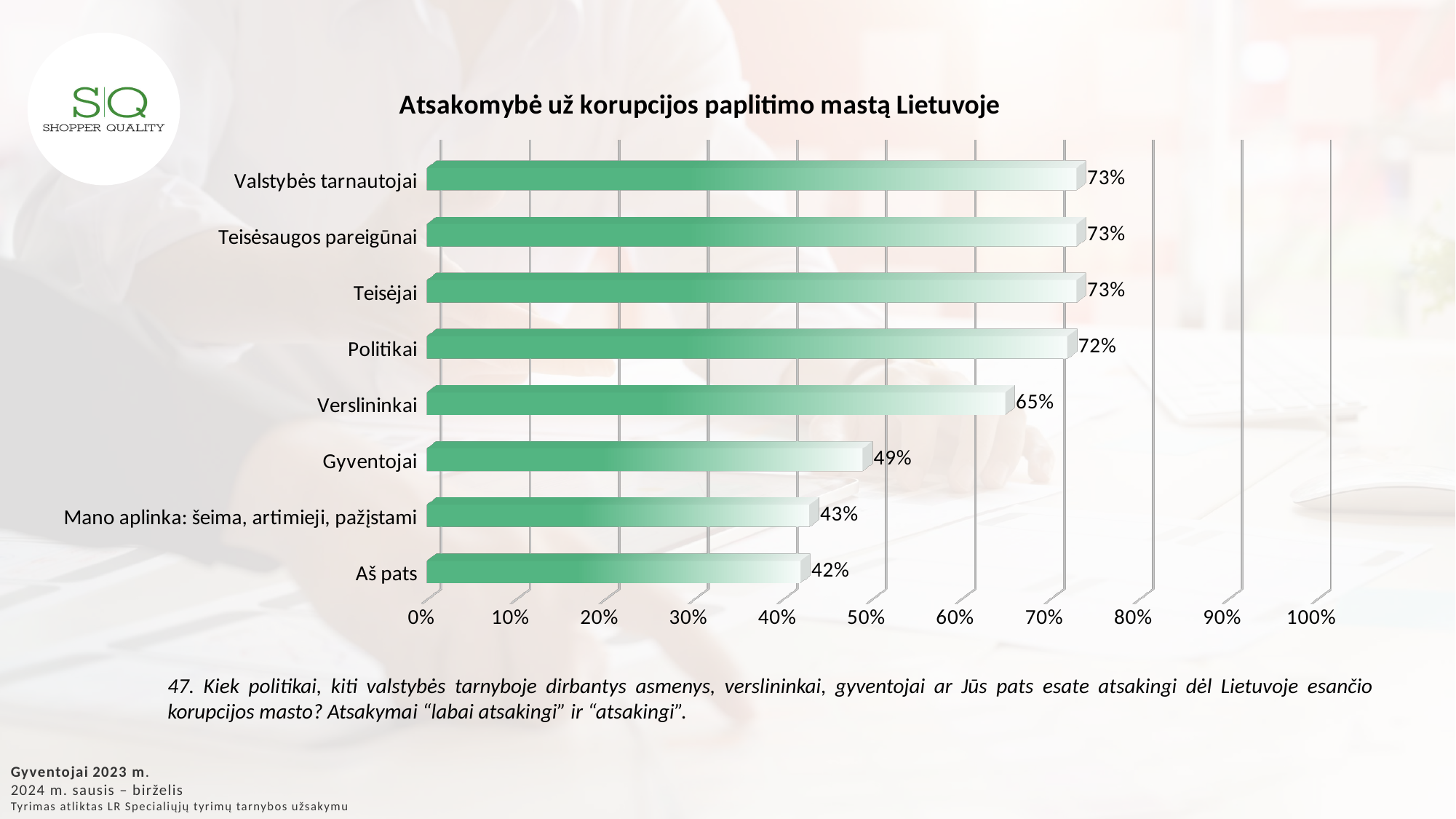
What kind of chart is shown on the slide? bar chart What is the value for Aš pats? 42% How many categories are shown in the chart? 8 What is the value for Verslininkai? 65% Which is larger, the value for Verslininkai or the value for Gyventojai? Verslininkai What is the difference between the values for Verslininkai and Aš pats? 23% What is the title of the chart? Atsakomybė už korupcijos paplitimo mastą Lietuvoje What is the value for Politikai? 72% What is the difference between the values for Politikai and Gyventojai? 23% What is the value for Mano aplinka: šeima, artimieji, pažįstami? 43% What is the value for Gyventojai? 49% Which category has the lowest value? Aš pats